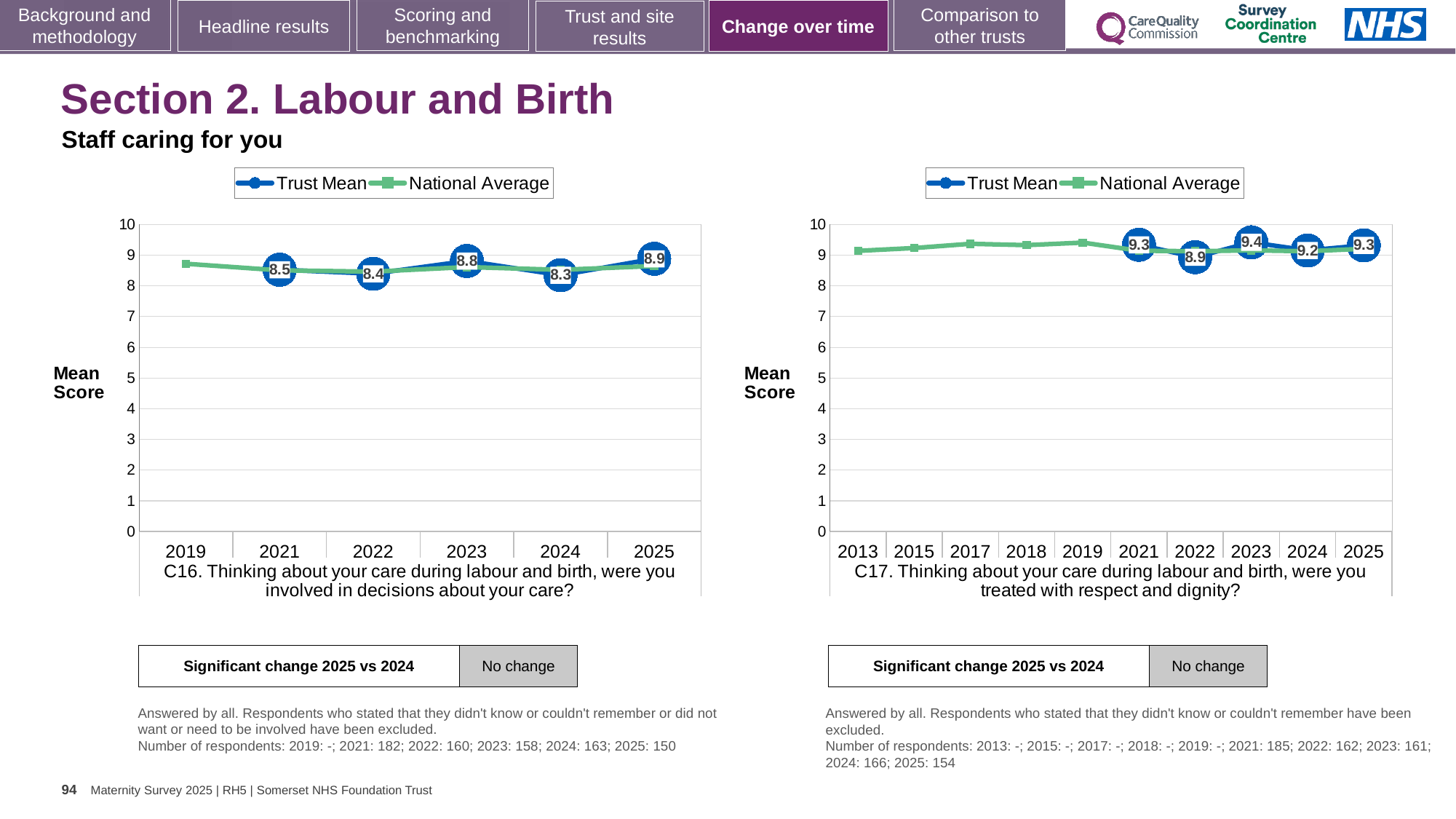
On the C17 chart (right), how many series does the legend list? 2 On the C16 chart (left), how many years are shown on the x axis? 6 On the C16 chart (left), what is the difference between the Trust Mean for 2025 and 2024? 0.6 On the C17 chart (right), what is the Trust Mean for 2022? 8.9 On the C17 chart (right), what is the Trust Mean for 2023? 9.4 On the C17 chart (right), is the Trust Mean for 2023 larger or smaller than for 2024? larger On the C16 chart (left), which year has the lowest labelled Trust Mean? 2024 On the C16 chart (left), which year has the highest Trust Mean? 2025 On the C16 chart (left), what is the Trust Mean for 2024? 8.3 On the C17 chart (right), which year has the lowest labelled Trust Mean? 2022 On the C16 chart (left), what is the Trust Mean for 2025? 8.9 What type of chart is the C17 chart (right)? line chart